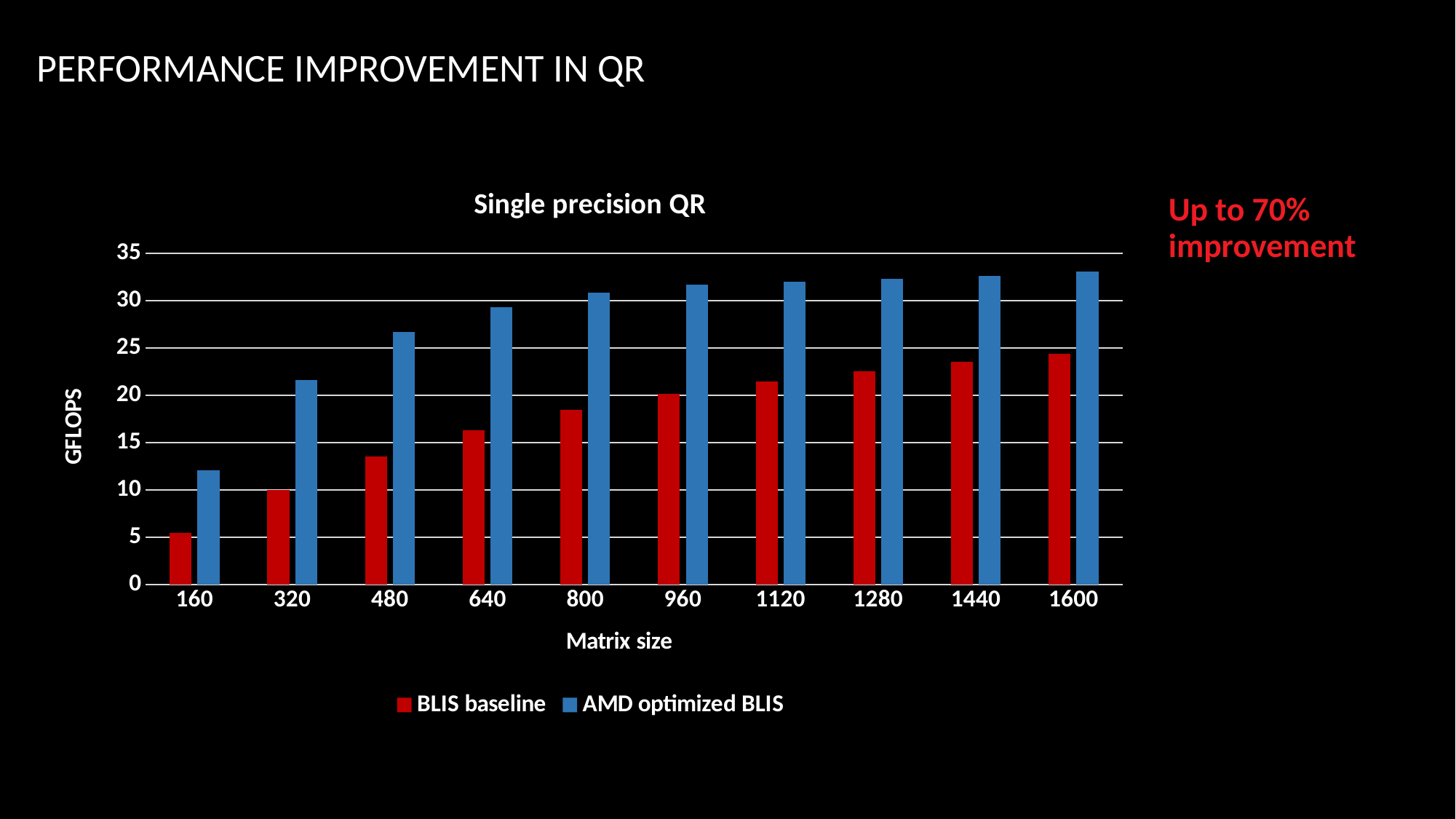
What kind of chart is shown on the slide? Bar chart Is the AMD optimized BLIS value for matrix size 1600 greater or less than 30 GFLOPS? greater At matrix size 640, which series has the larger value, BLIS baseline or AMD optimized BLIS? AMD optimized BLIS Is the BLIS baseline value for matrix size 160 greater or less than 10 GFLOPS? less How many series does the legend list? 2 Which matrix size has the highest BLIS baseline value? 1600 Which matrix size has the lowest BLIS baseline value? 160 What is the title of the chart? Single precision QR Is the AMD optimized BLIS value for matrix size 480 greater or less than 25 GFLOPS? greater Do the AMD optimized BLIS values rise or fall as matrix size increases? Rise How many matrix sizes are shown on the x axis? 10